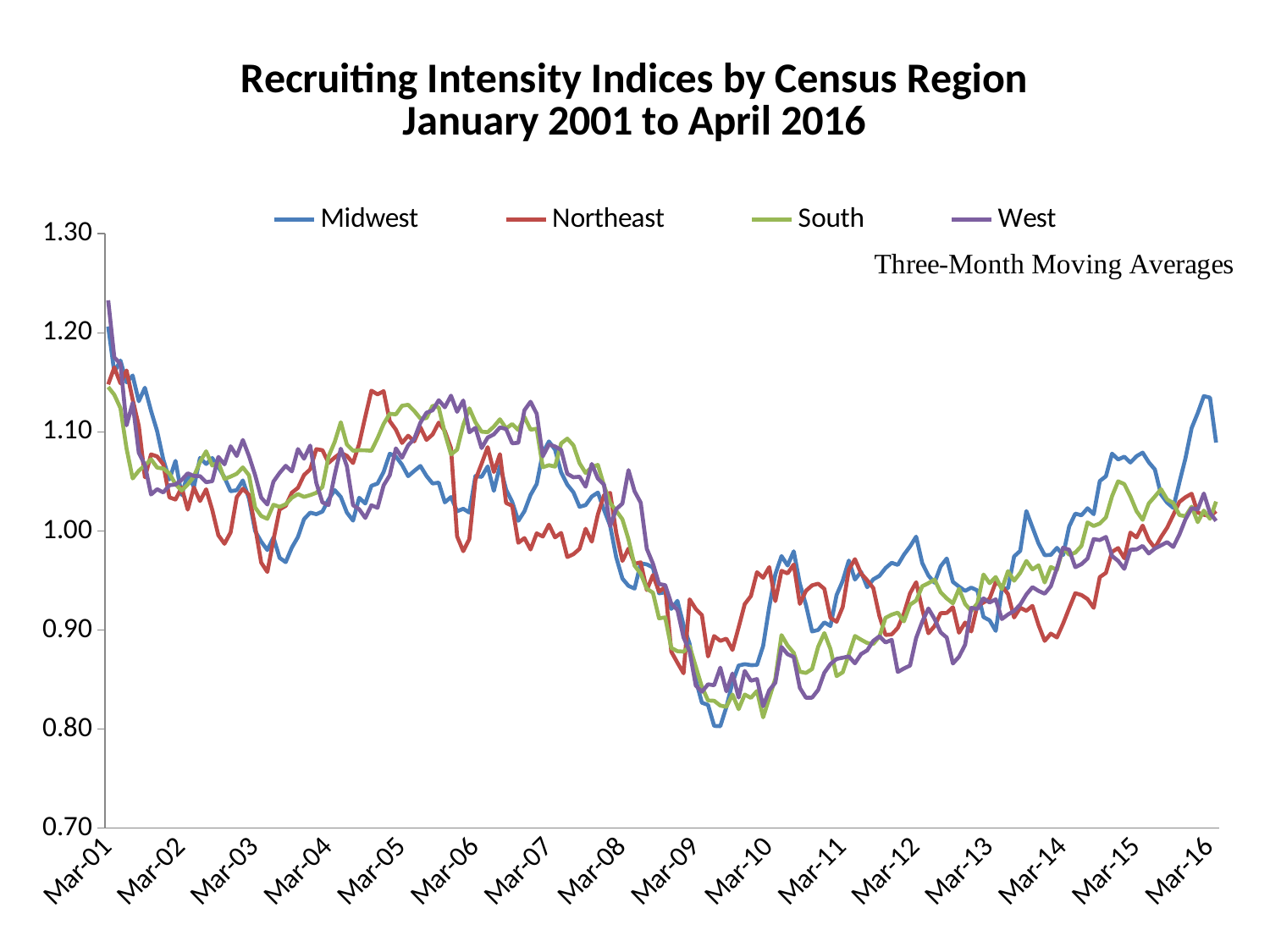
Which series reaches the lowest point on the chart? Midwest What kind of chart is shown on the slide? Line chart Is the Midwest value around Mar-09 greater or less than 0.90? less Is the Midwest value at its peak near Mar-16 greater or less than 1.10? greater What is the title of the chart? Recruiting Intensity Indices by Census Region January 2001 to April 2016 Near Mar-16, which series is higher, Midwest or West? Midwest Is the Northeast value around Mar-10 greater or less than 0.90? greater Do the Midwest values rise or fall between Mar-08 and Mar-09? fall Which four regions are listed in the legend? Midwest, Northeast, South, West How many series does the legend list? 4 Around Mar-10, which series is higher, Northeast or South? Northeast